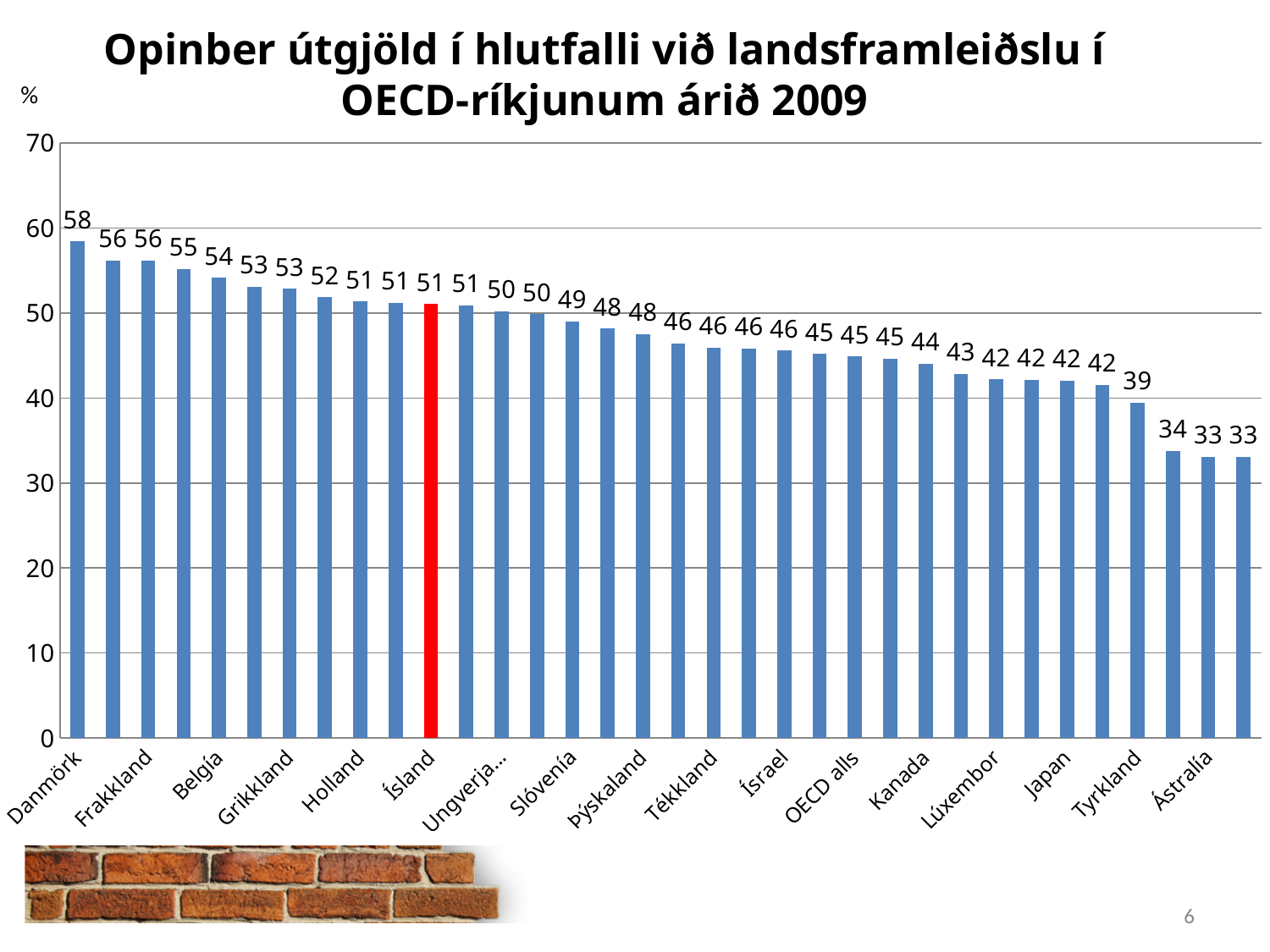
Which country has the highest value? Danmörk What is the value for Tyrkland? 39 How many bars are plotted in the chart? 34 What is the value for Kanada? 44 What is the value for OECD alls? 45 What is the difference between the values for Danmörk and Ísland? 7 What is the value for Ísland? 51 What is the value for Danmörk? 58 Is the value for Grikkland greater or less than 50? greater Which is larger, the value for Frakkland or the value for Japan? Frakkland What kind of chart is shown? bar chart Which country's bar is highlighted in red? Ísland